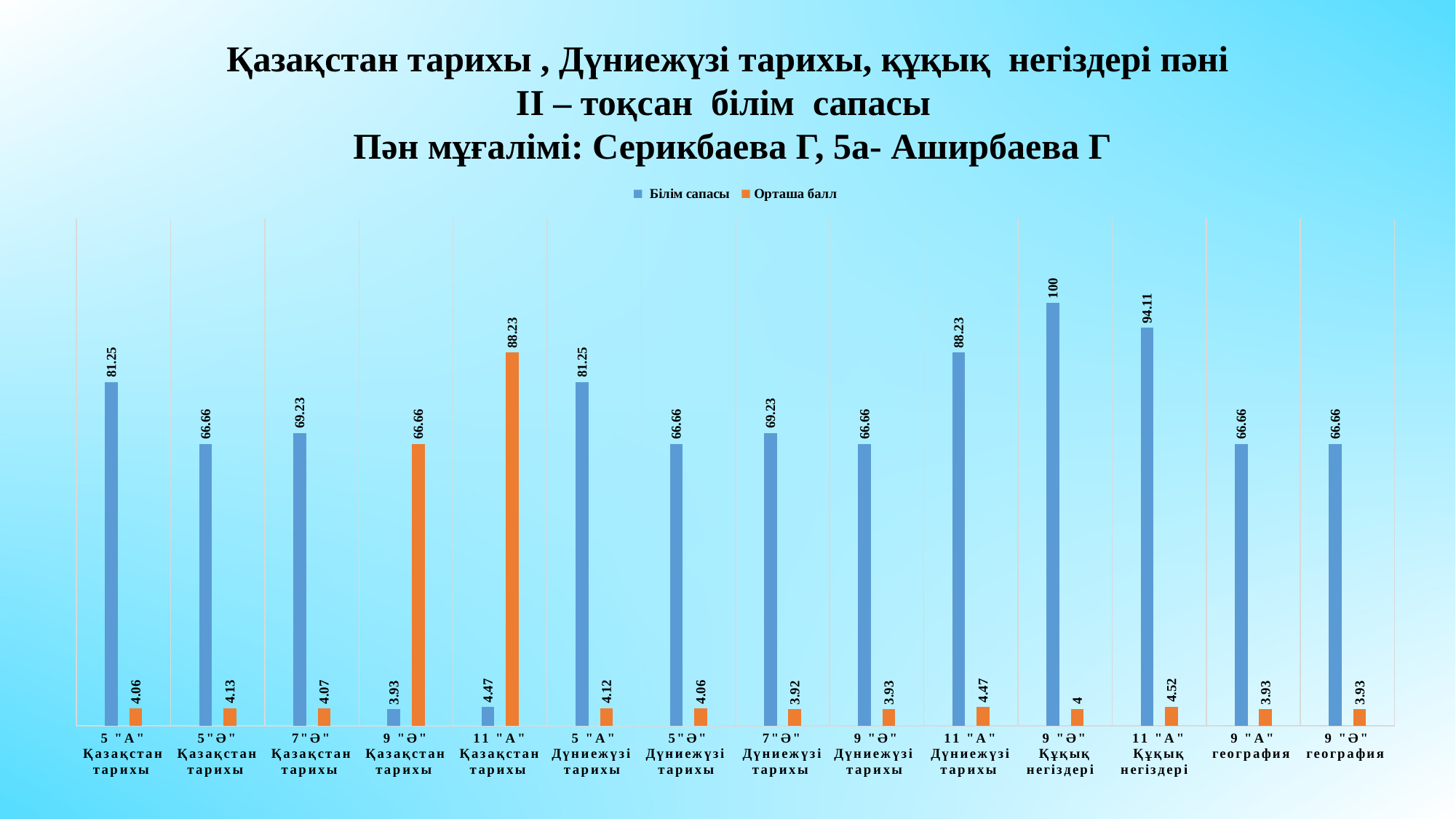
Which category has the highest Білім сапасы value? 9 "Ә" Құқық негіздері What is the difference between the Білім сапасы values for 9 "Ә" Құқық негіздері and 11 "А" Құқық негіздері? 5.89 What is the Білім сапасы value for 9 "Ә" Құқық негіздері? 100 How many series does the legend list? 2 What is the difference between the Білім сапасы values for 11 "А" Дүниежүзі тарихы and 5 "А" Дүниежүзі тарихы? 6.98 What kind of chart is shown on the slide? Bar chart What is the Білім сапасы value for 7"Ә" Дүниежүзі тарихы? 69.23 What is the Орташа балл value for 11 "А" Құқық негіздері? 4.52 Which has the larger Білім сапасы value: 5 "А" Қазақстан тарихы or 7"Ә" Қазақстан тарихы? 5 "А" Қазақстан тарихы What value is shown for the orange bar at 11 "А" Қазақстан тарихы? 88.23 What is the Орташа балл value for 7"Ә" Дүниежүзі тарихы? 3.92 How many categories are shown on the x axis? 14